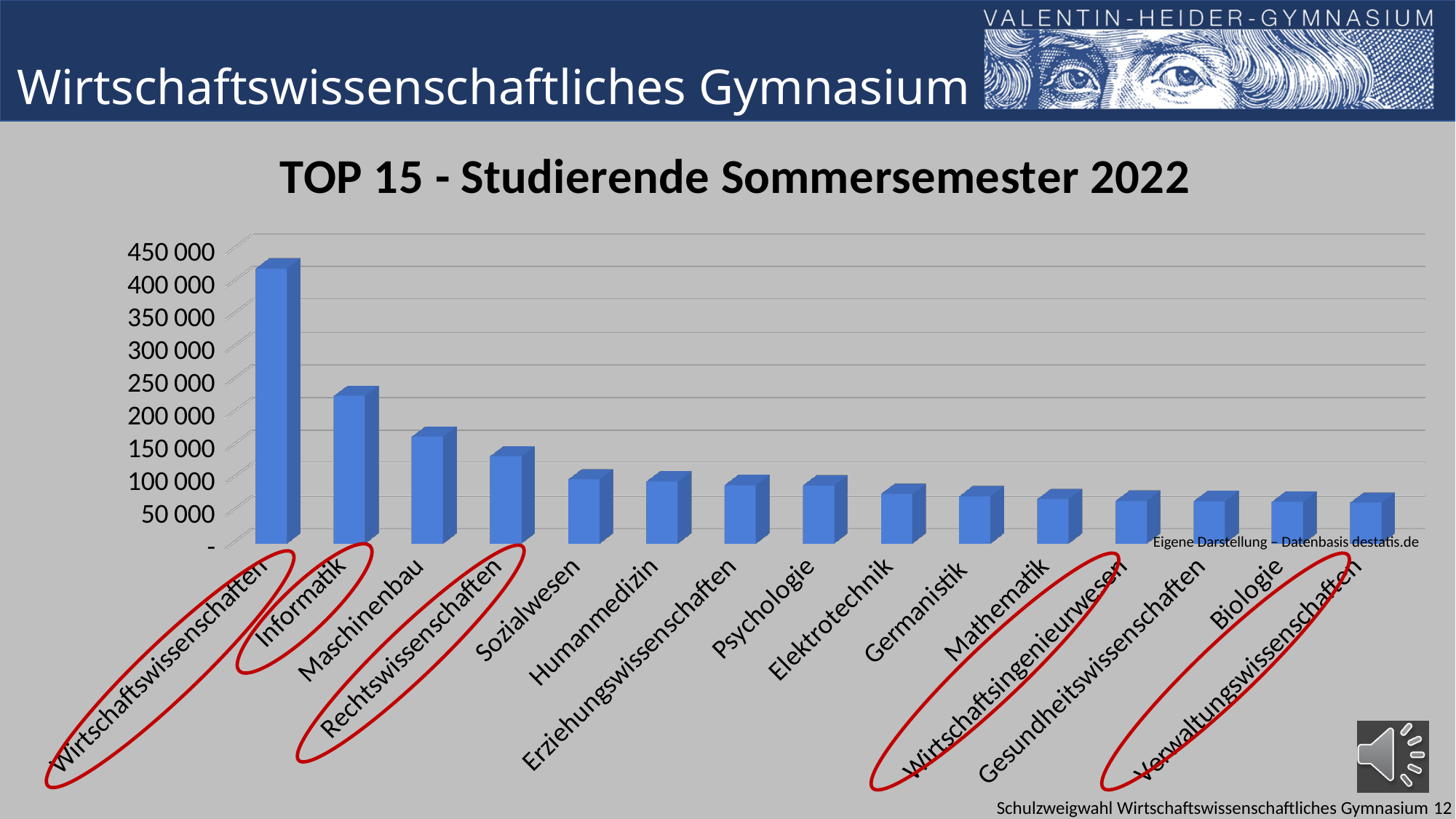
Is the value for Elektrotechnik greater or less than 100 000? less Is the value for Maschinenbau greater or less than 200 000? less Is the value for Informatik greater or less than 200 000? greater How many categories (subjects) are shown on the x axis of the chart? 15 Do the values rise or fall from left to right along the x axis? fall Which subject has the highest number of students in the chart? Wirtschaftswissenschaften Which has more students, Informatik or Maschinenbau? Informatik How many subject labels on the x axis are circled in red? 5 What is the title of the chart? TOP 15 - Studierende Sommersemester 2022 What kind of chart is shown on the slide? bar chart